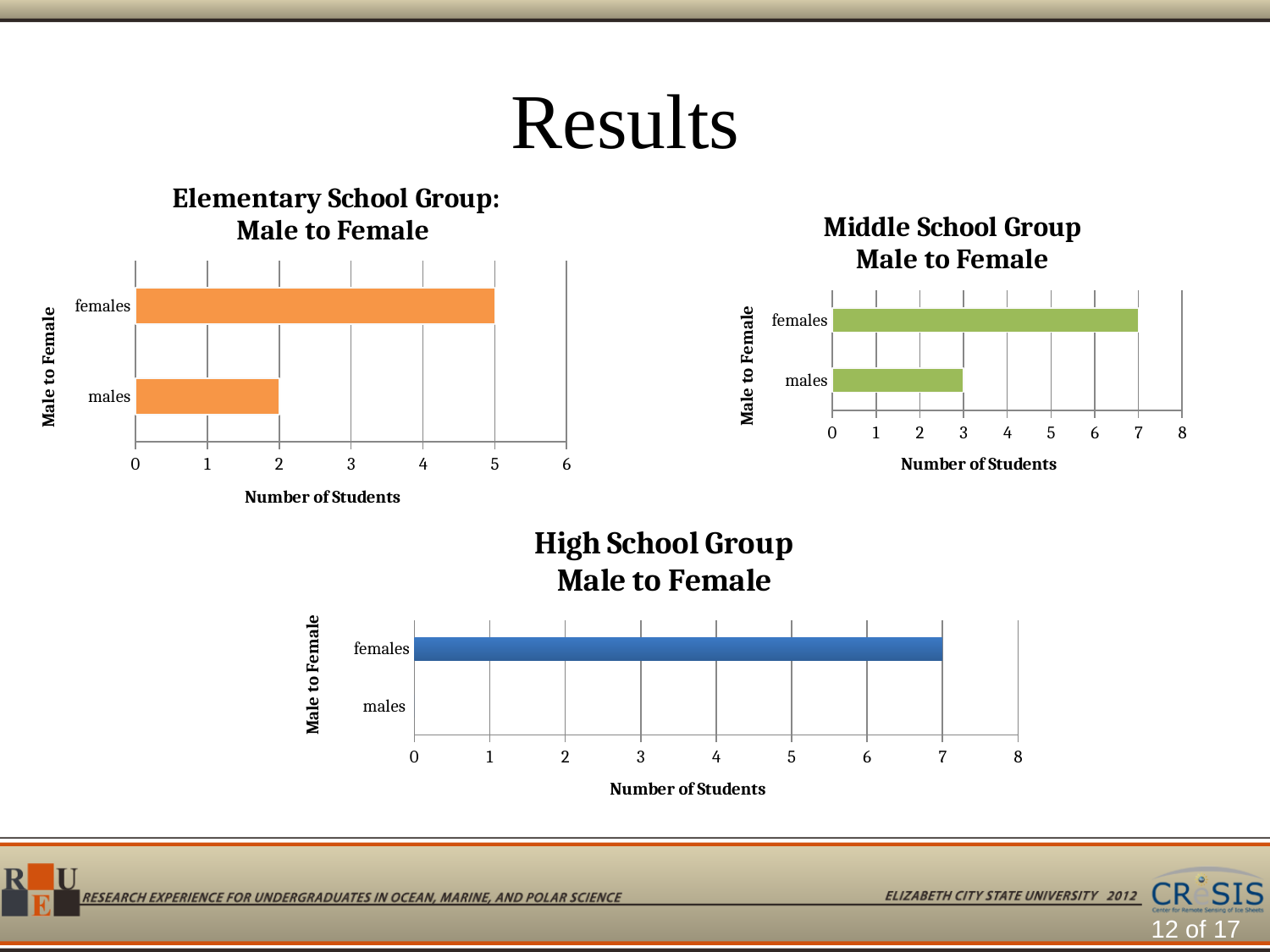
In the Middle School Group chart, what is the number of students for females? 7 In the Middle School Group chart, what is the number of students for males? 3 In the Middle School Group chart, which category has the lowest number of students? males In the Elementary School Group chart, what is the number of students for females? 5 In the High School Group chart, what is the number of students for females? 7 In the Elementary School Group chart, which category has the highest number of students? females In the Elementary School Group chart, what is the number of students for males? 2 In the Middle School Group chart, what is the difference between the number of females and the number of males? 4 How many categories are shown in the Middle School Group chart? 2 In the High School Group chart, is the value for females greater or less than 5? greater What type of chart is the High School Group chart? bar chart In the Elementary School Group chart, which is larger, the value for females or the value for males? females